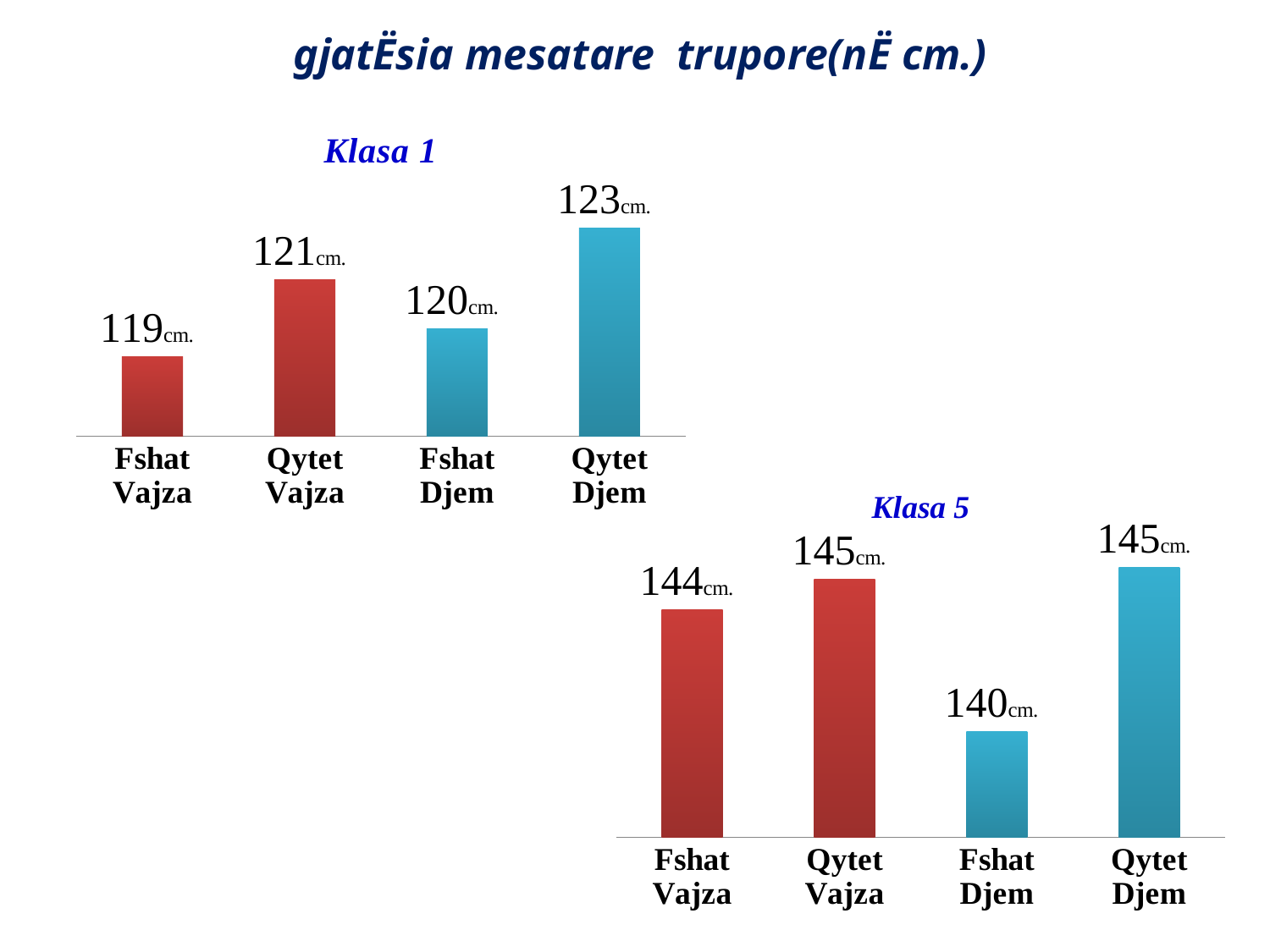
In the Klasa 1 chart, what is the value for Qytet Djem? 123 cm. In the Klasa 5 chart, what is the value for Fshat Vajza? 144 cm. How many categories are shown in the Klasa 5 chart? 4 What type of chart is the Klasa 1 chart? Bar chart In the Klasa 5 chart, which category has the lowest value? Fshat Djem In the Klasa 1 chart, what is the difference between Qytet Djem and Fshat Vajza? 4 cm. In the Klasa 1 chart, which category has the lowest value? Fshat Vajza In the Klasa 1 chart, which category has the highest value? Qytet Djem In the Klasa 5 chart, what is the difference between Qytet Vajza and Fshat Djem? 5 cm. In the Klasa 1 chart, which is larger, Qytet Vajza or Fshat Djem? Qytet Vajza In the Klasa 5 chart, what is the value for Fshat Djem? 140 cm. In the Klasa 1 chart, what is the value for Fshat Vajza? 119 cm.